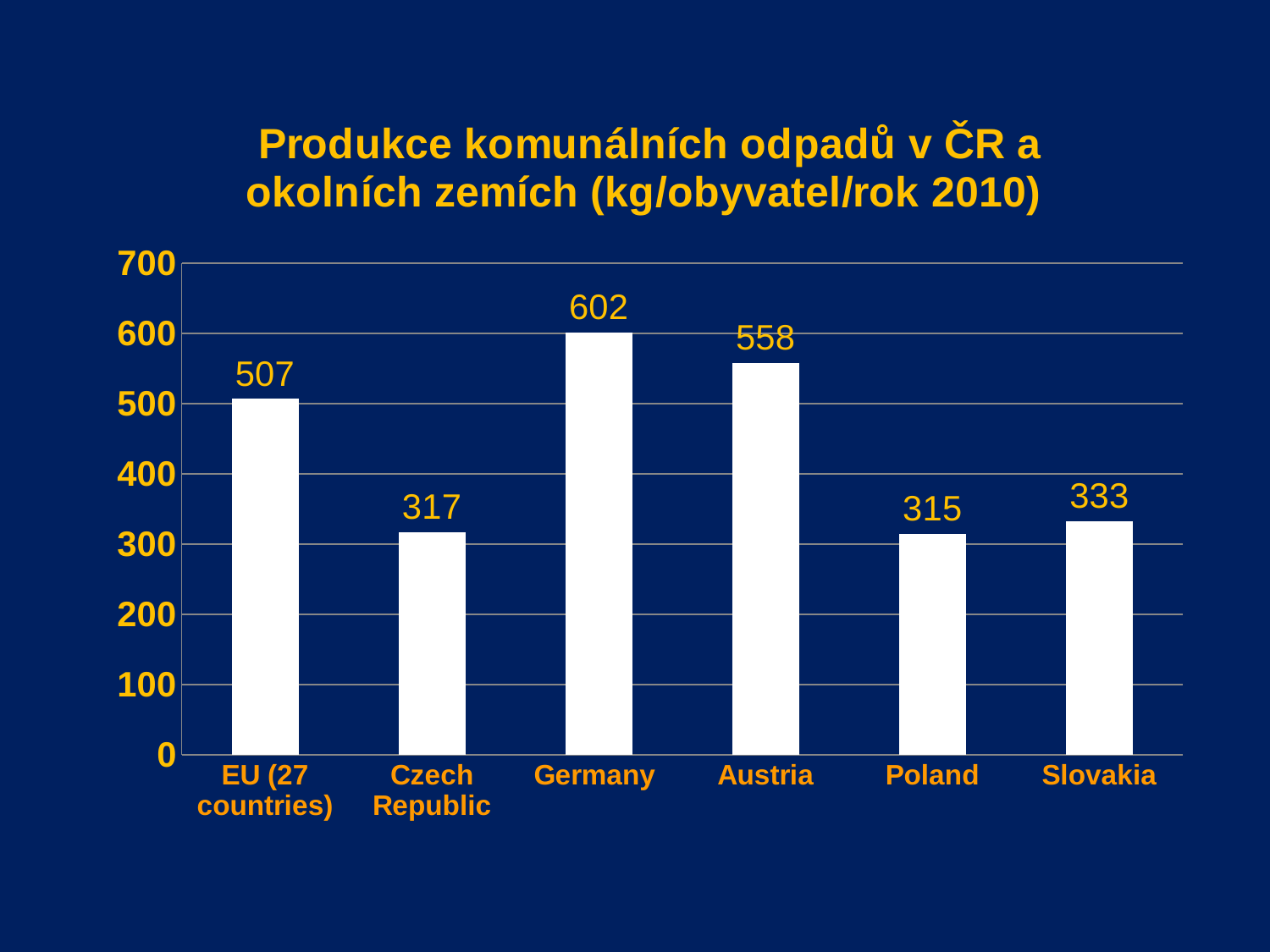
What is the value for Germany? 602 What kind of chart is shown on the slide? bar chart How many categories are shown on the x axis? 6 What is the difference between the values for Germany and Austria? 44 Which category has the lowest value? Poland What is the title of the chart? Produkce komunálních odpadů v ČR a okolních zemích (kg/obyvatel/rok 2010) What is the value for EU (27 countries)? 507 Which is larger, the value for Austria or the value for EU (27 countries)? Austria What is the value for the Czech Republic? 317 Is the value for Slovakia greater or less than 400? less What is the difference between the values for Slovakia and the Czech Republic? 16 Which country has the highest value? Germany